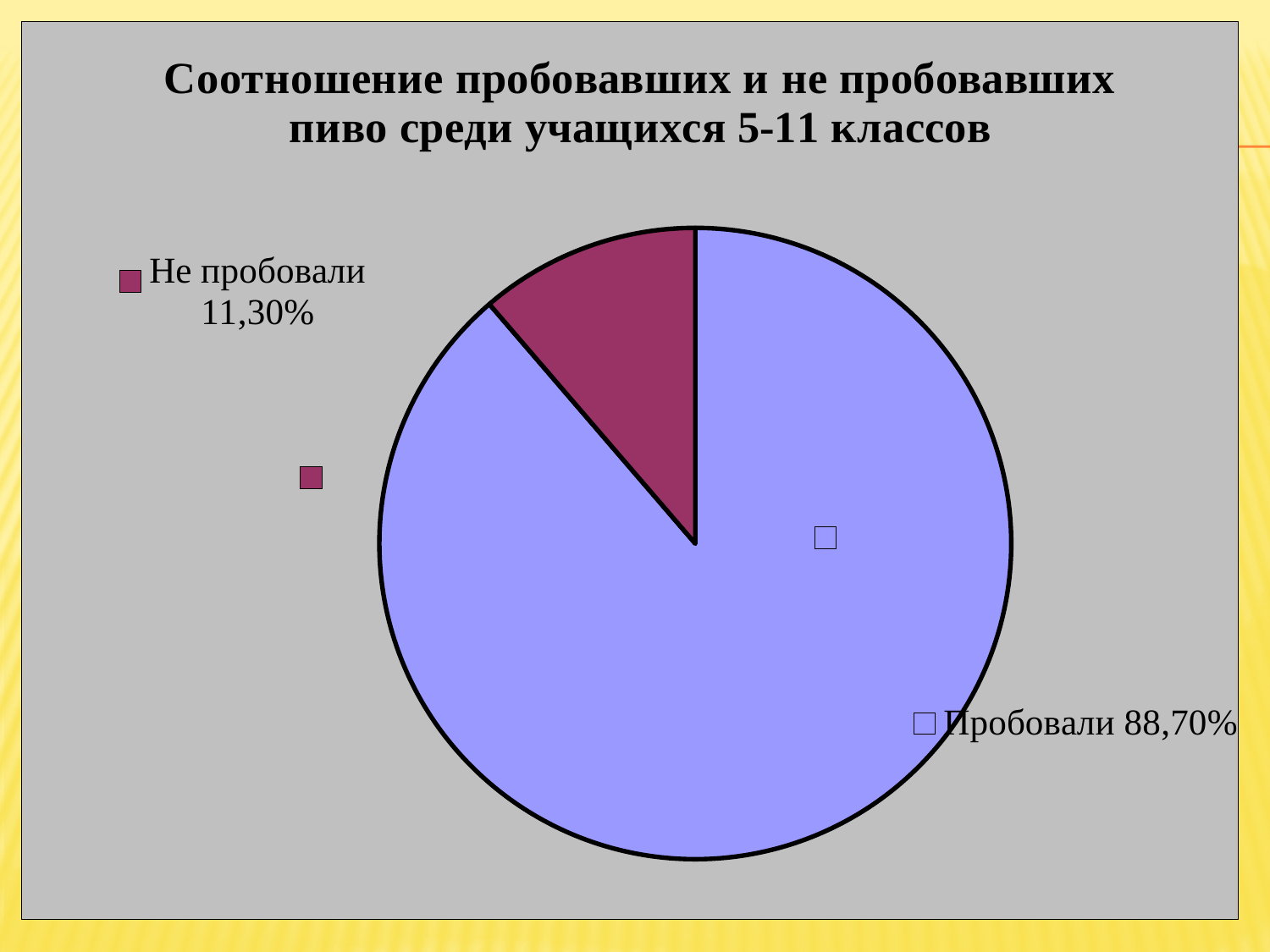
Which is larger, the share of "Пробовали" or "Не пробовали"? Пробовали What is the value for "Пробовали"? 88,70% How many slices does the pie chart have? 2 What colour is the slice for "Не пробовали"? dark magenta (purple-red) Which category has the largest share of the pie? Пробовали What is the value for "Не пробовали"? 11,30% What kind of chart is shown on the slide? pie chart What is the title of the chart? Соотношение пробовавших и не пробовавших пиво среди учащихся 5-11 классов Which category has the smallest share of the pie? Не пробовали What is the total of the two slices shown? 100,00% What is the difference between the shares of "Пробовали" and "Не пробовали"? 77,40%